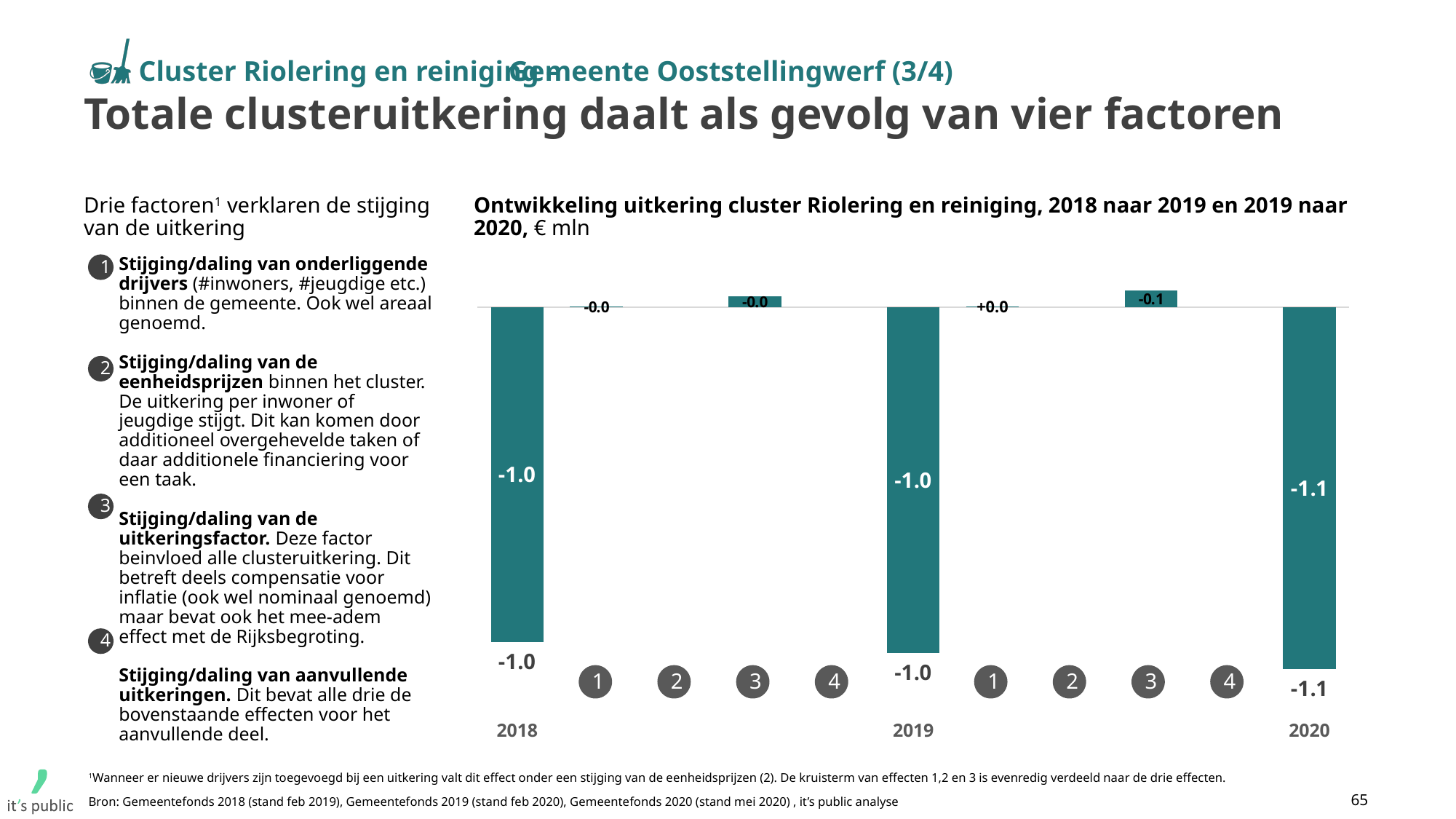
What is the difference between the 2020 value and the 2018 value? 0.1 Which year has the lowest (most negative) total value: 2018, 2019 or 2020? 2020 Is the 2020 bar larger in magnitude than the 2019 bar? Yes, 2020 (-1.1) What is the value labelled for factor 3 between 2019 and 2020? -0.1 How many year totals are shown in the chart? 3 What is the value labelled for factor 1 between 2018 and 2019? -0.0 What is the value of the cluster payment for 2020 in the chart? -1.1 In what unit are the values in the chart expressed? € mln What is the value labelled for factor 1 between 2019 and 2020? +0.0 What kind of chart is shown on the slide? Bar chart (waterfall) What is the value of the cluster payment for 2018 in the chart? -1.0 What is the value of the cluster payment for 2019 in the chart? -1.0